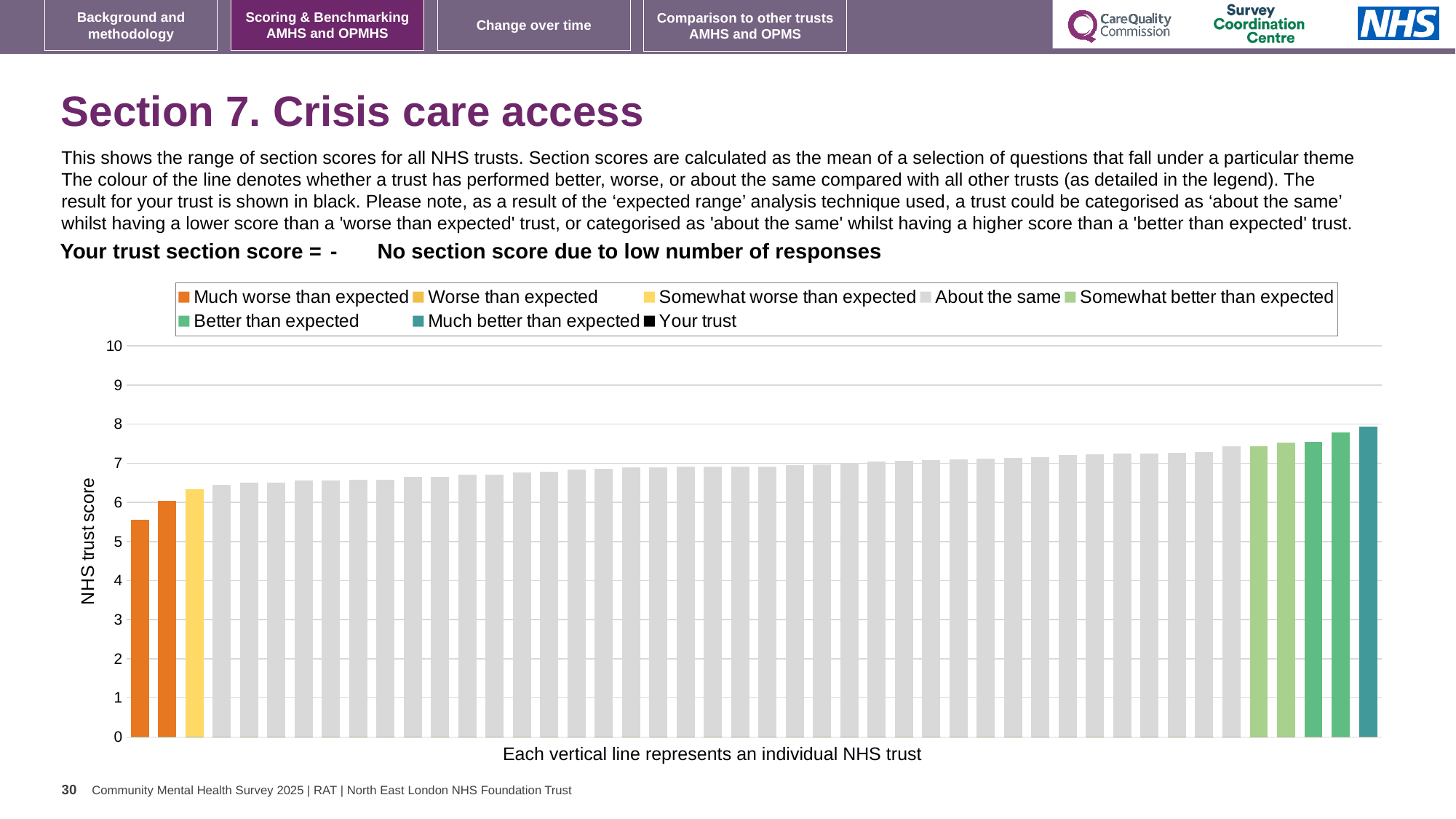
Which legend category does the highest bar in the chart belong to? Much better than expected What does each vertical line in the chart represent, according to the x-axis label? An individual NHS trust How many bars in the chart are in the 'Much better than expected' category? 1 Is the value of the highest (rightmost) bar greater or less than 7? greater Do the bar values rise or fall moving from left to right along the x axis? Rise Which legend category does the lowest bar in the chart belong to? Much worse than expected How many entries does the chart legend list? 8 What is the label on the vertical axis of the chart? NHS trust score How many bars in the chart are in the 'Much worse than expected' category? 2 Is the value of the lowest (leftmost) bar greater or less than 5? greater What kind of chart is shown on the slide? Bar chart Is the value of the lowest (leftmost) bar greater or less than 6? less